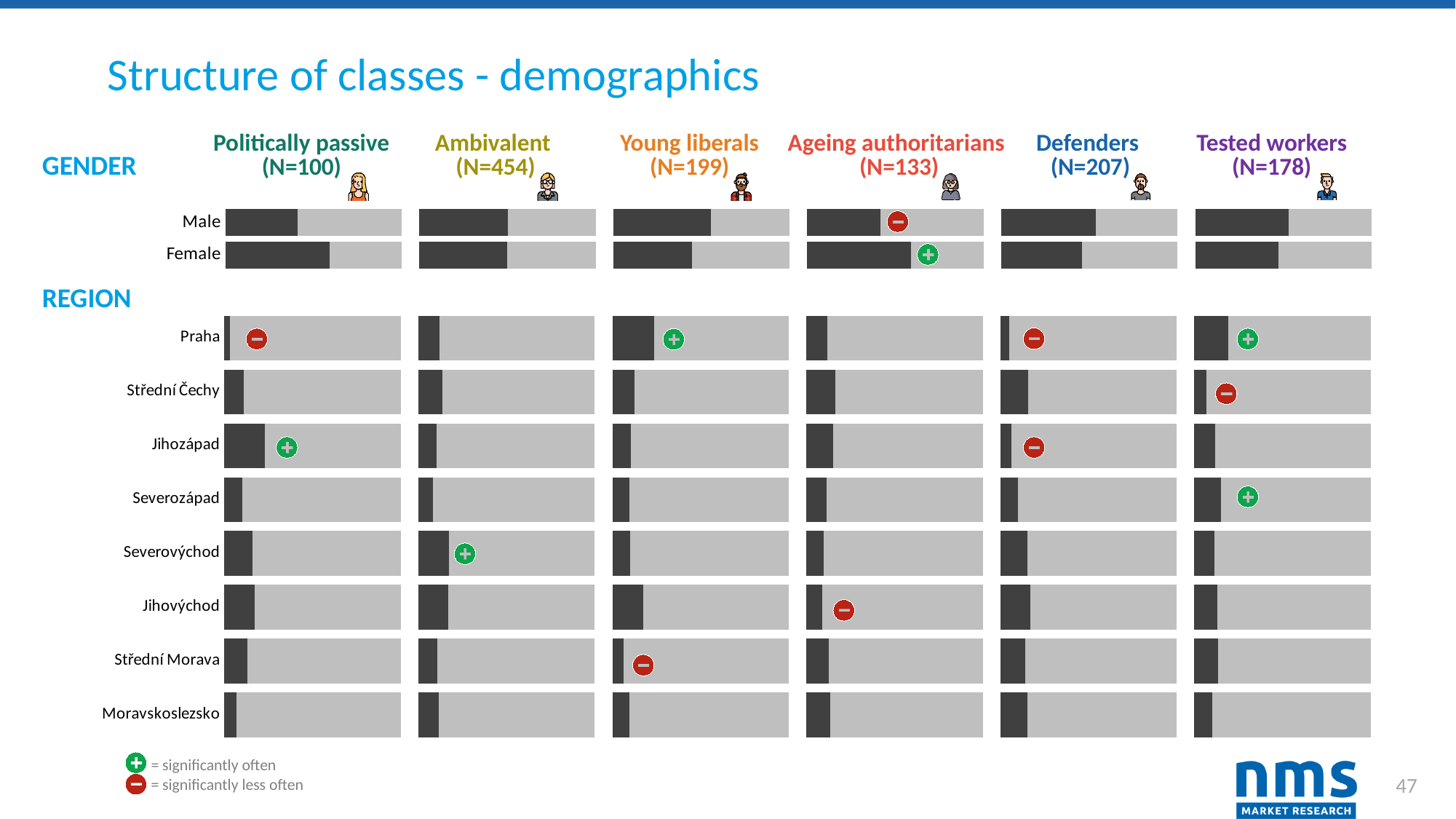
In the Politically passive column, which region has the shortest bar? Praha How many regions are listed in the REGION section? 8 In the Young liberals column, which region has the longest bar? Praha In the Young liberals column, which gender bar is longer, Male or Female? Male According to the legend, what does the green plus symbol mean? significantly often In the Defenders column, which gender bar is longer, Male or Female? Male In the Politically passive column, which gender bar is longer, Male or Female? Female In the Defenders column, which region has the shortest bar? Praha How many classes (columns) are shown across the top of the chart? 6 What kind of chart is used to show the gender and region breakdowns on this slide? bar chart What is the sample size (N) shown for the Ambivalent class? N=454